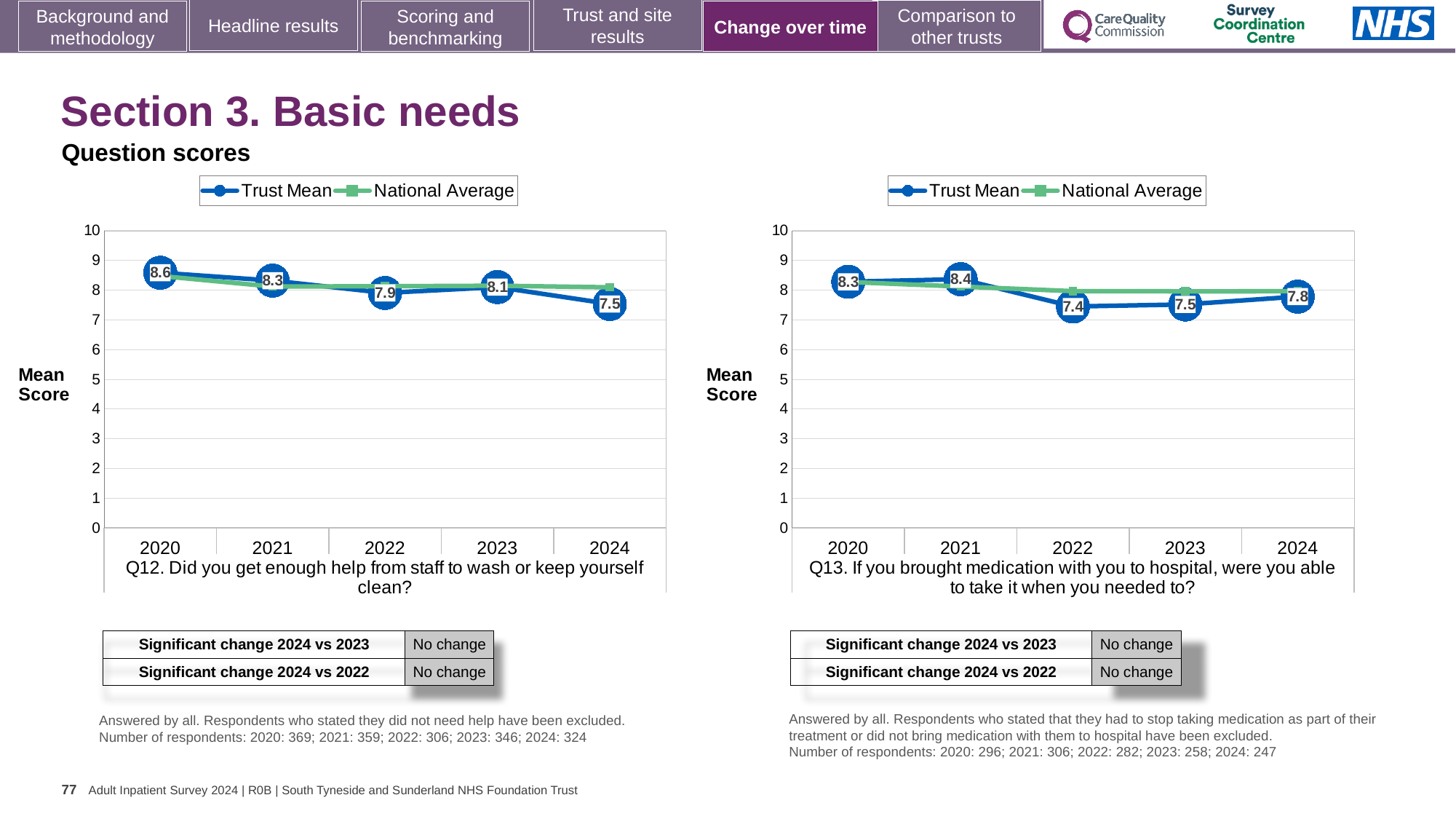
In the Q12 chart (left), what is the Trust Mean for 2024? 7.5 In the Q13 chart (right), what is the difference between the Trust Mean in 2021 and in 2022? 1.0 What type of chart is used for Q13 (right)? Line chart In the Q13 chart (right), what is the Trust Mean for 2022? 7.4 In the Q12 chart (left), which year has the lowest Trust Mean? 2024 In the Q13 chart (right), is the Trust Mean higher in 2020 or in 2024? 2020 In the Q12 chart (left), what is the Trust Mean for 2020? 8.6 In the Q12 chart (left), what is the difference between the Trust Mean in 2020 and in 2024? 1.1 In the Q13 chart (right), is the National Average for 2022 greater or less than 7? greater How many series does the legend of the Q12 chart (left) list? 2 In the Q13 chart (right), which year has the highest Trust Mean? 2021 In the Q12 chart (left), how many years are plotted on the x axis? 5